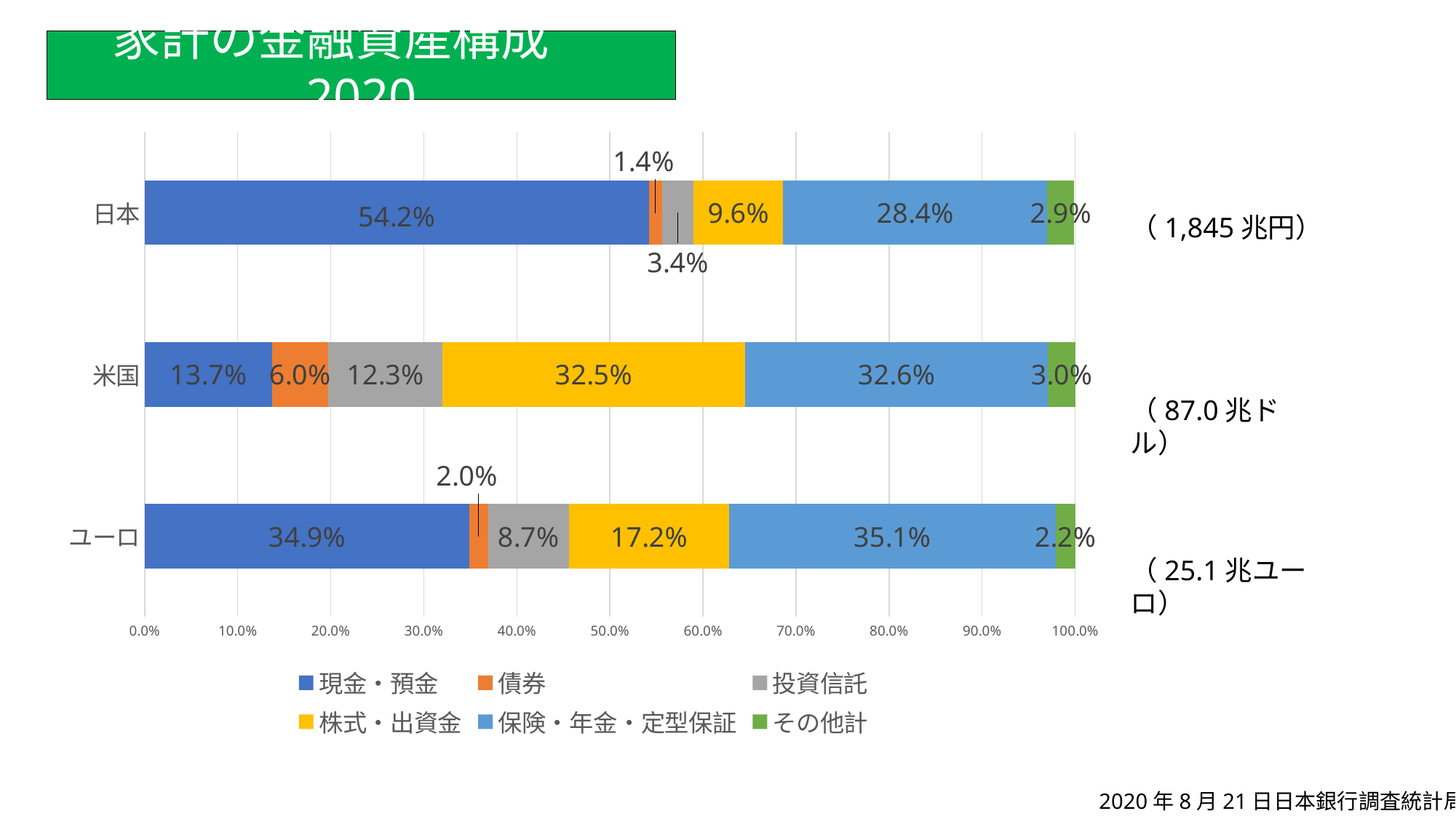
Which category has the highest value for 現金・預金? 日本 What is the value for 現金・預金 for 日本? 54.2% What is the value for 債券 for 日本? 1.4% How many categories are shown on the y axis? 3 Which category has the lowest value for 株式・出資金? 日本 Which is larger, the 投資信託 value for 米国 or for ユーロ? 米国 What is the value for 保険・年金・定型保証 for ユーロ? 35.1% What kind of chart is shown on the slide? Stacked bar chart How many series does the legend list? 6 What is the difference between the 現金・預金 values for 日本 and 米国? 40.5% Which colour represents 株式・出資金 in the chart? Yellow What is the value for 株式・出資金 for 米国? 32.5%